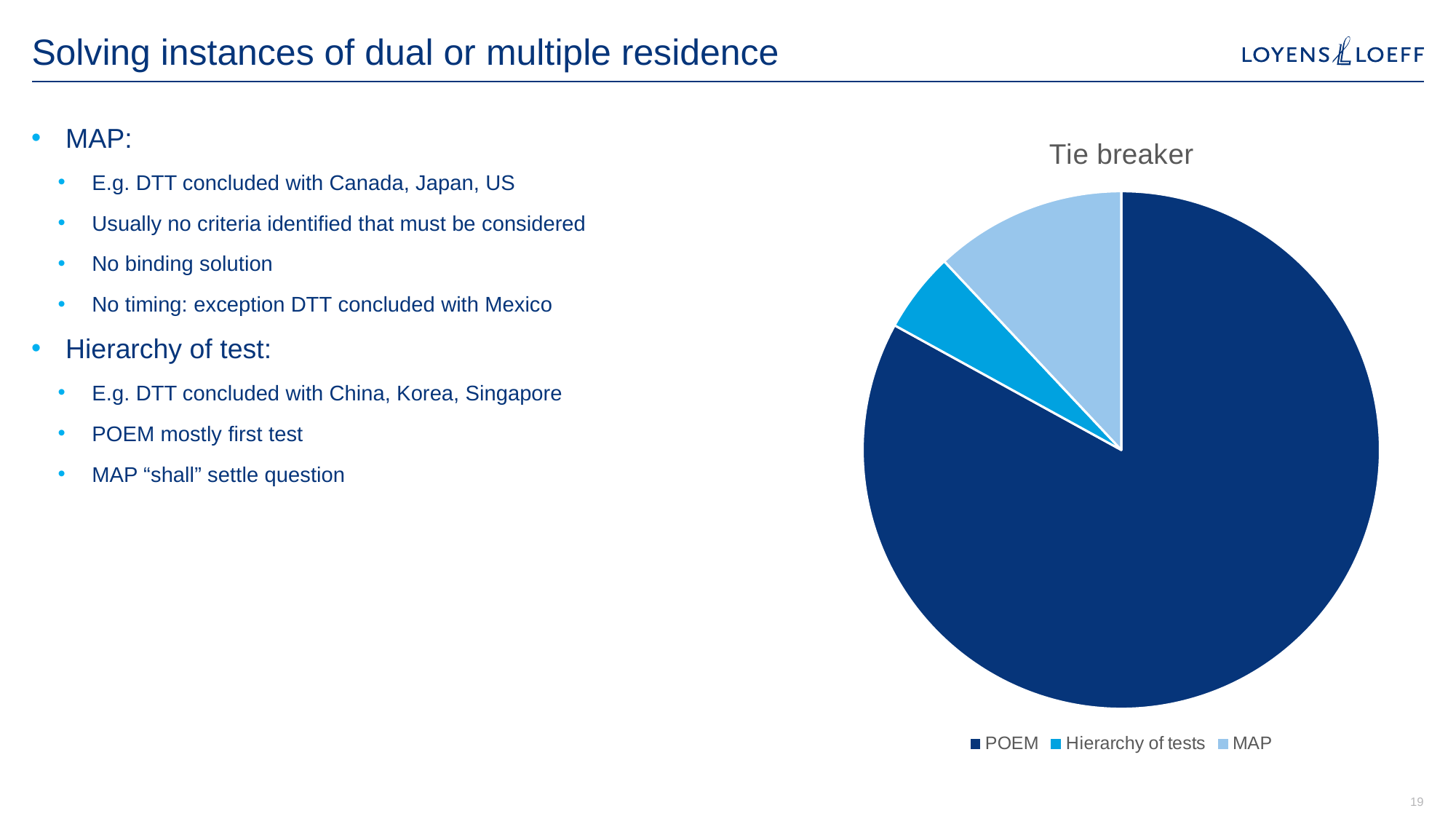
How many slices does the pie chart have? 3 Which category is shown in the darkest blue in the pie chart? POEM Which slice is larger, MAP or Hierarchy of tests? MAP Which category has the largest slice of the pie? POEM What is the title of the chart? Tie breaker Which category has the smallest slice of the pie? Hierarchy of tests Does the POEM slice take up more or less than half of the pie? More What kind of chart is shown on the slide? Pie chart Which slice is larger, POEM or MAP? POEM How many entries does the chart legend list? 3